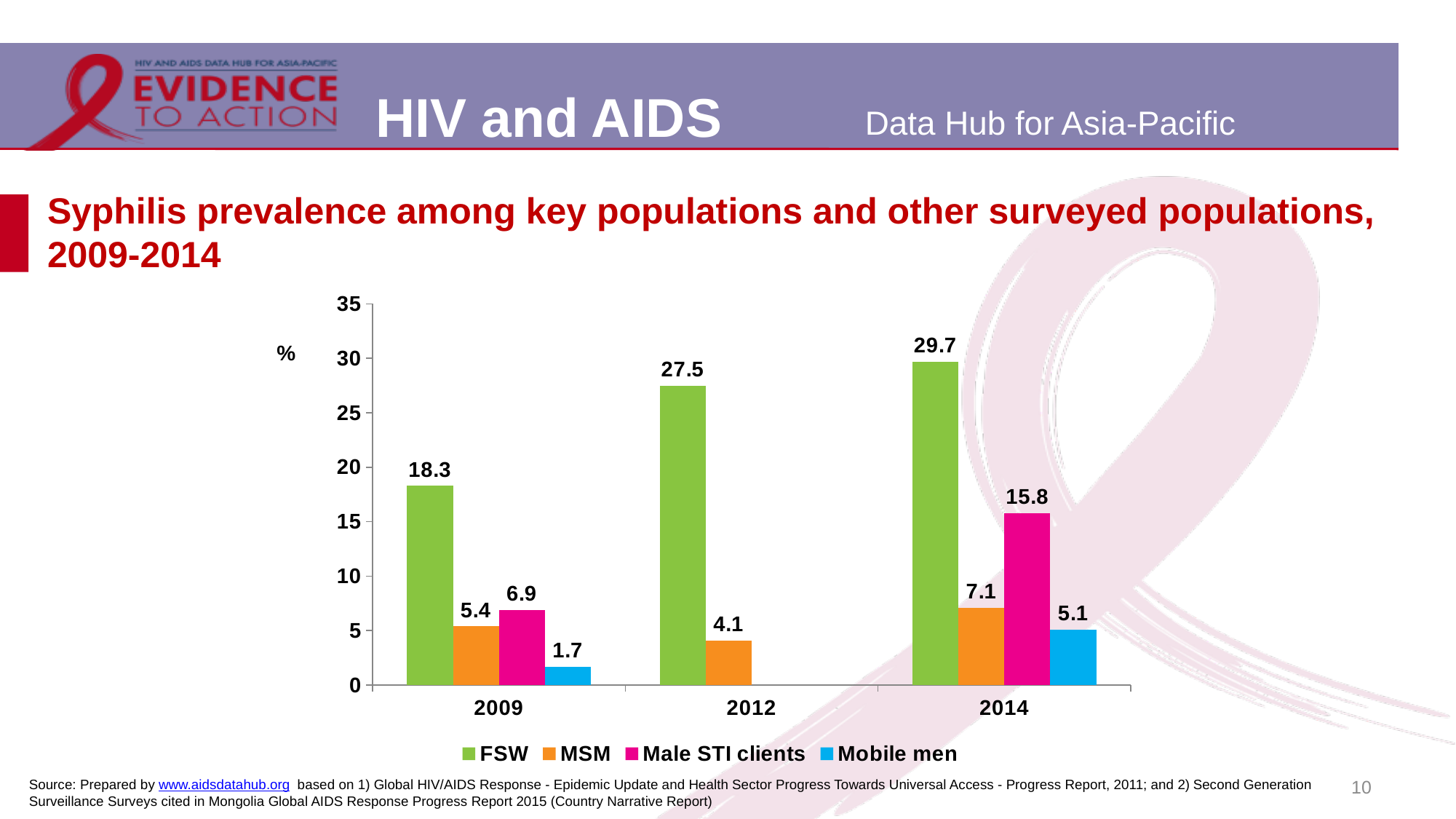
How many series does the legend list? 4 What kind of chart is shown on the slide? Bar chart How many years are shown on the x axis? 3 What is the difference between the FSW values in 2014 and 2009? 11.4 Do the FSW values rise or fall from 2009 to 2014? Rise Which is larger: the MSM value in 2014 or the MSM value in 2012? MSM value in 2014 What is the syphilis prevalence among FSW in 2012? 27.5 Which colour represents Male STI clients in the legend? Pink Which group has the lowest value in 2009? Mobile men What is the value for Male STI clients in 2014? 15.8 What is the value for Mobile men in 2009? 1.7 In which year is the FSW value highest? 2014